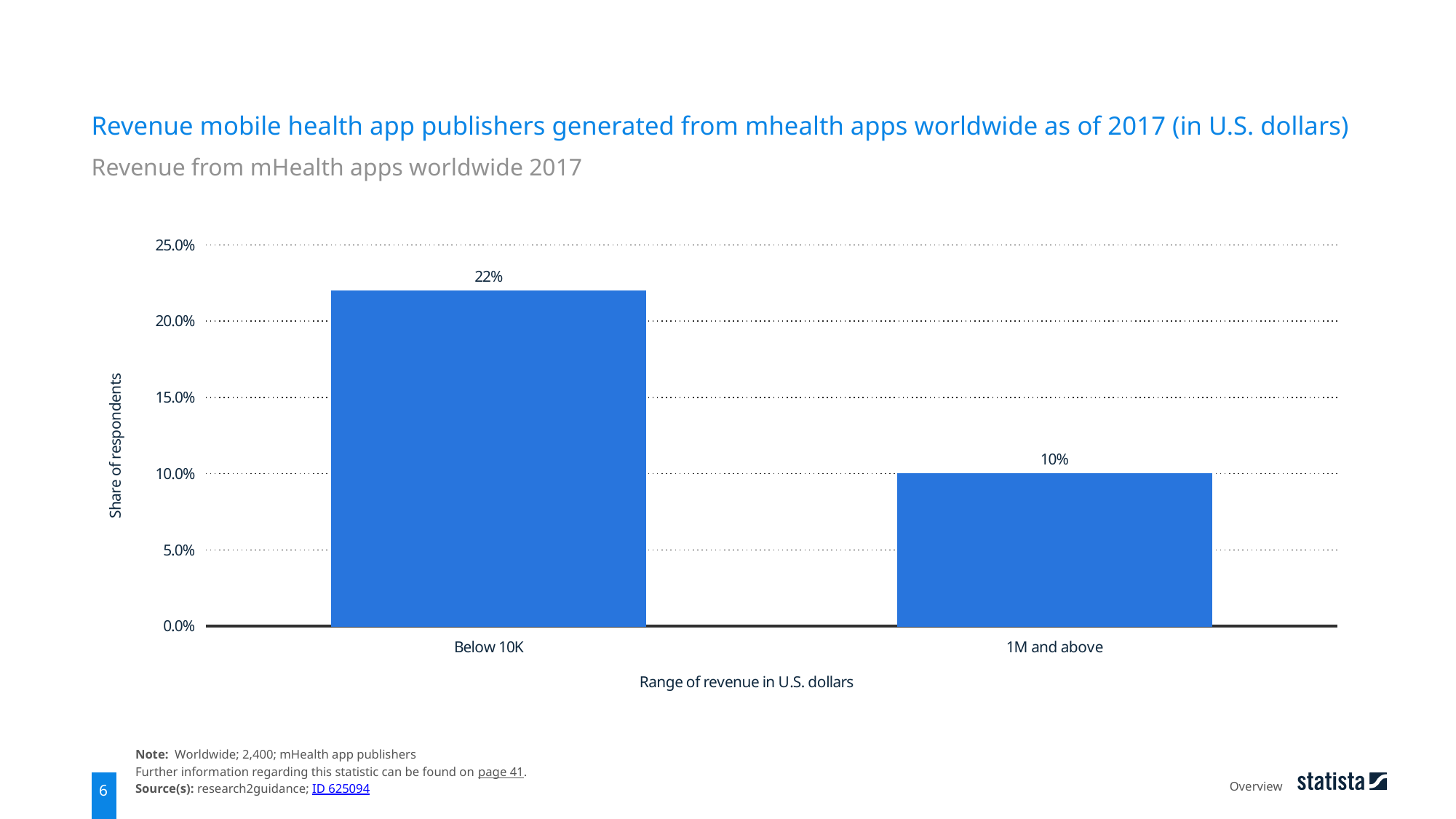
What is the share of respondents for the 'Below 10K' revenue range? 22% Is the value for 'Below 10K' greater or less than 20.0%? greater What is the label of the x-axis? Range of revenue in U.S. dollars What kind of chart is shown on the slide? Bar chart Is the value for '1M and above' greater or less than 15.0%? less Which revenue range has the lowest share of respondents? 1M and above What is the share of respondents for the '1M and above' revenue range? 10% Which is larger: the share for 'Below 10K' or for '1M and above'? Below 10K Which revenue range has the highest share of respondents? Below 10K What is the label of the y-axis? Share of respondents What is the difference in percentage points between the 'Below 10K' and '1M and above' shares? 12 percentage points How many revenue range categories are shown on the chart? 2